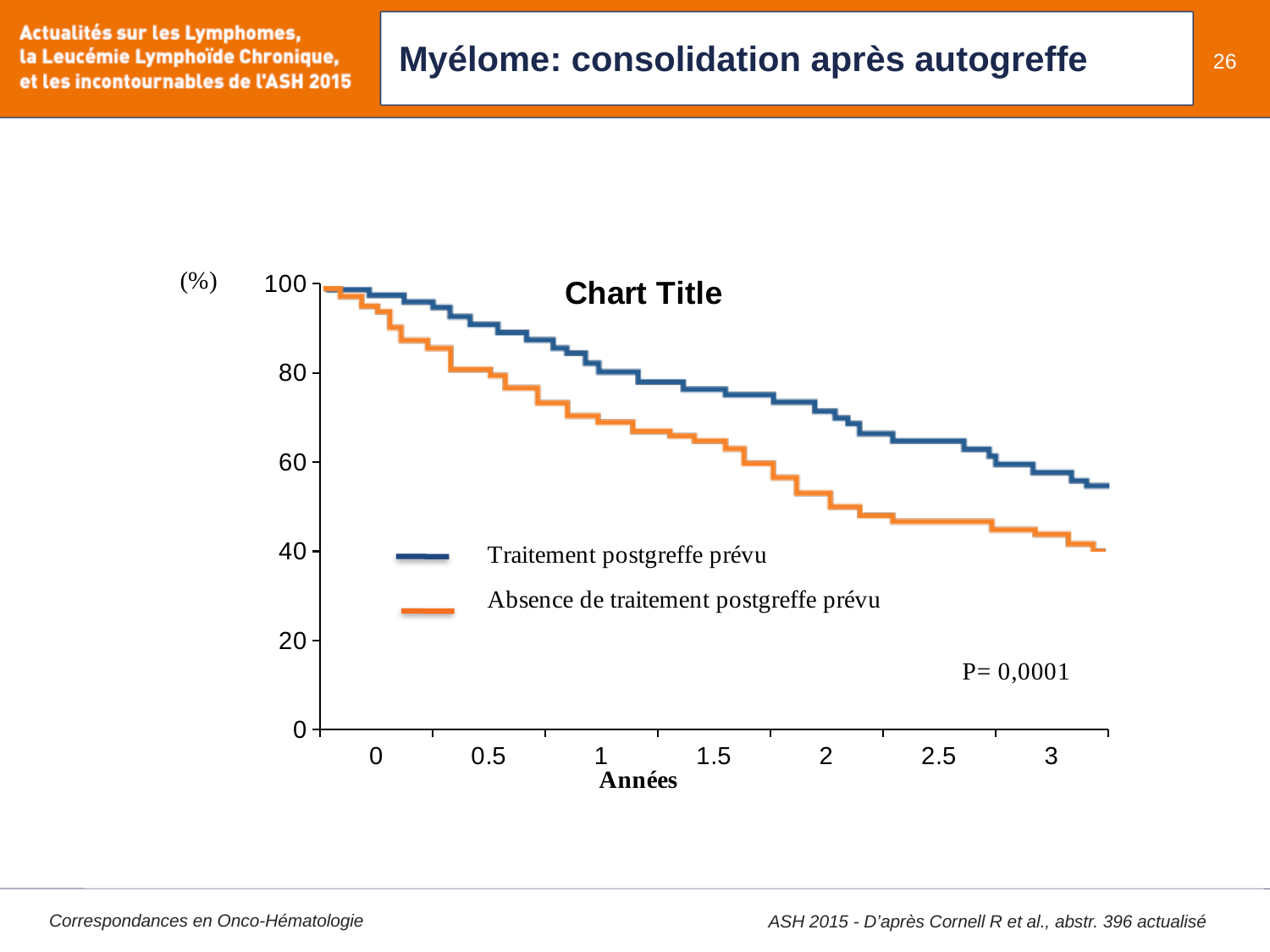
Do the values for 'Traitement postgreffe prévu' rise or fall along the x axis? fall Is the value for 'Absence de traitement postgreffe prévu' at 3 years greater or less than 60? less Do the values for 'Absence de traitement postgreffe prévu' rise or fall over time? fall At 2 years, which series has the higher value: 'Traitement postgreffe prévu' or 'Absence de traitement postgreffe prévu'? Traitement postgreffe prévu Is the value for 'Absence de traitement postgreffe prévu' at 2 years greater or less than 60? less Is the value for 'Absence de traitement postgreffe prévu' at 1 year greater or less than 60? greater Which series is shown in orange? Absence de traitement postgreffe prévu How many series does the legend list? 2 What kind of chart is shown on the slide? line chart What is the label of the x axis? Années